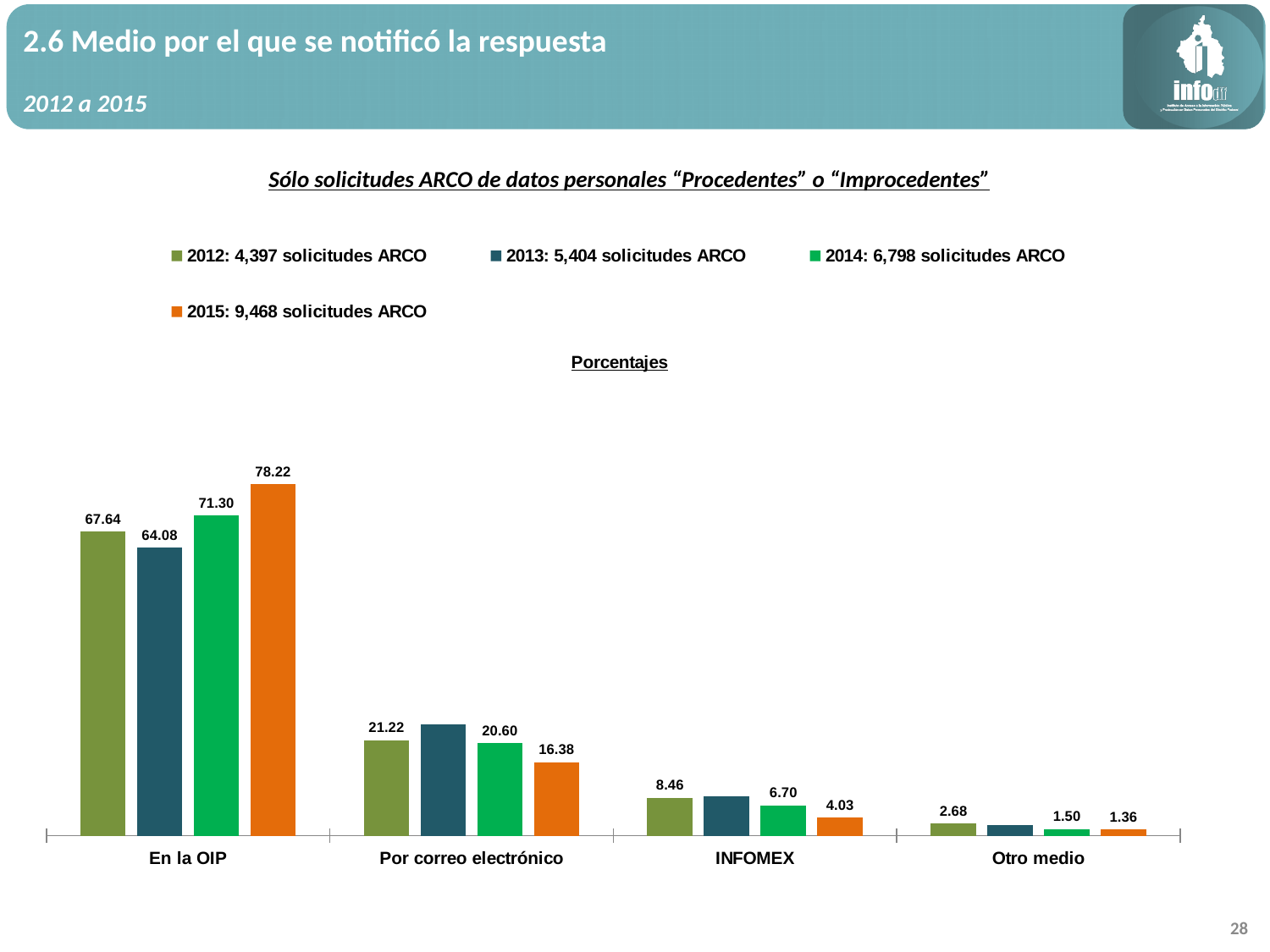
According to the legend, how many solicitudes ARCO were there in 2015? 9,468 What is the value for 'Otro medio' in the 2015 series? 1.36 How many series does the chart legend list? 4 What is the difference between the 2015 and 2012 values for 'En la OIP'? 10.58 What is the value for 'Por correo electrónico' in the 2012 series? 21.22 Which category has the highest value in the 2015 series? En la OIP How many categories are shown on the x axis of the chart? 4 What is the value for 'En la OIP' in the 2015 series? 78.22 Which category has the lowest value in the 2012 series? Otro medio What type of chart is shown on the slide? bar chart What is the value for 'INFOMEX' in the 2014 series? 6.70 Which is larger for 'Por correo electrónico': the 2014 value or the 2015 value? 2014